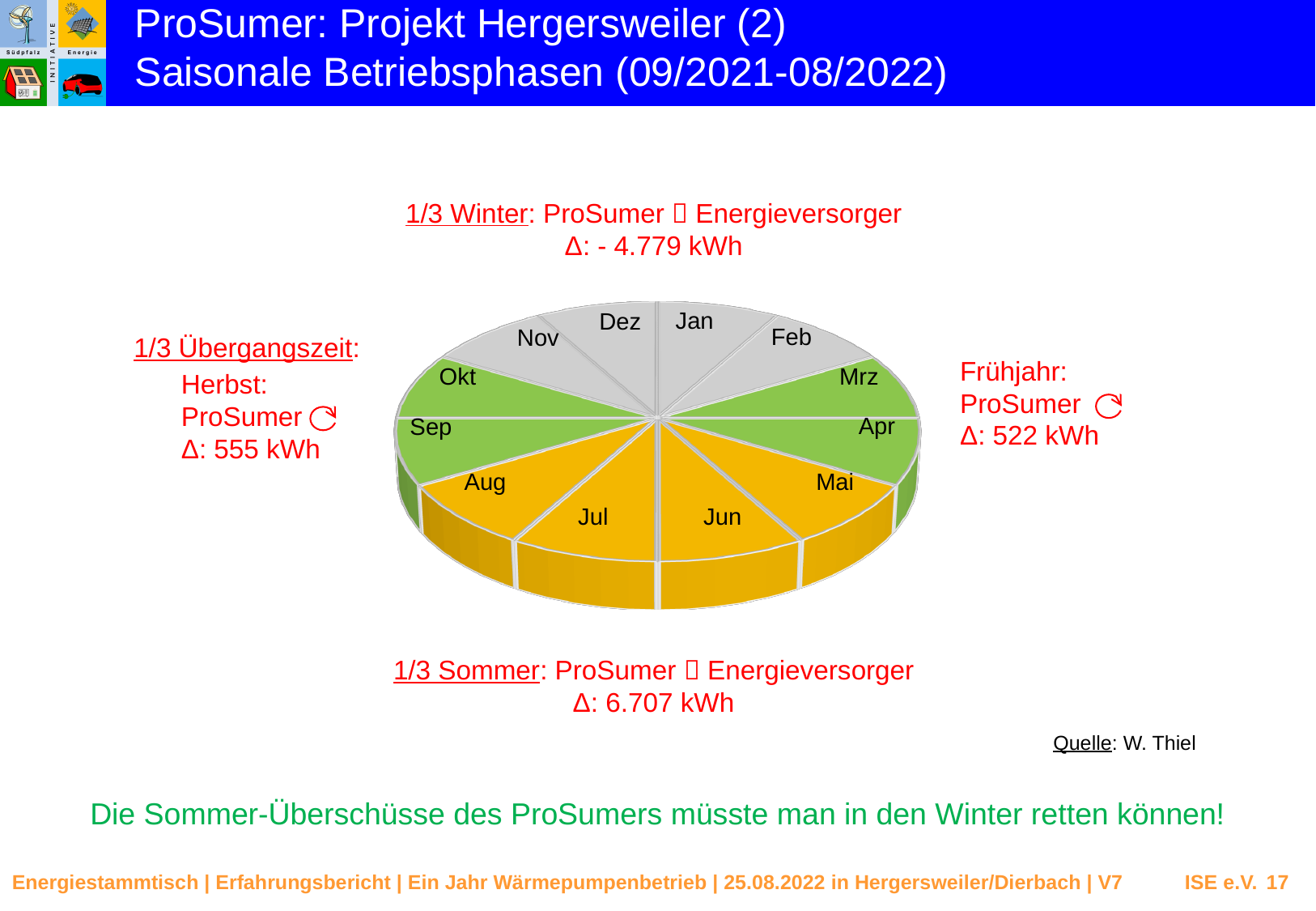
What kind of chart is shown on the slide? Pie chart Which months are shown in yellow/orange on the pie chart? Mai, Jun, Jul, Aug What share of the year does the Sommer phase cover according to the slide? 1/3 Which months are shown in grey on the pie chart? Nov, Dez, Jan, Feb Which has the larger Δ value, Herbst or Frühjahr? Herbst What share of the year does the Winter phase cover according to the slide? 1/3 What is the difference between the Δ values for Herbst and Frühjahr? 33 kWh What Δ value is given for the Sommer phase? 6.707 kWh What Δ value is given for Frühjahr? 522 kWh What Δ value is given for Herbst? 555 kWh What Δ value is given for the Winter phase? - 4.779 kWh How many slices does the pie chart have? 12